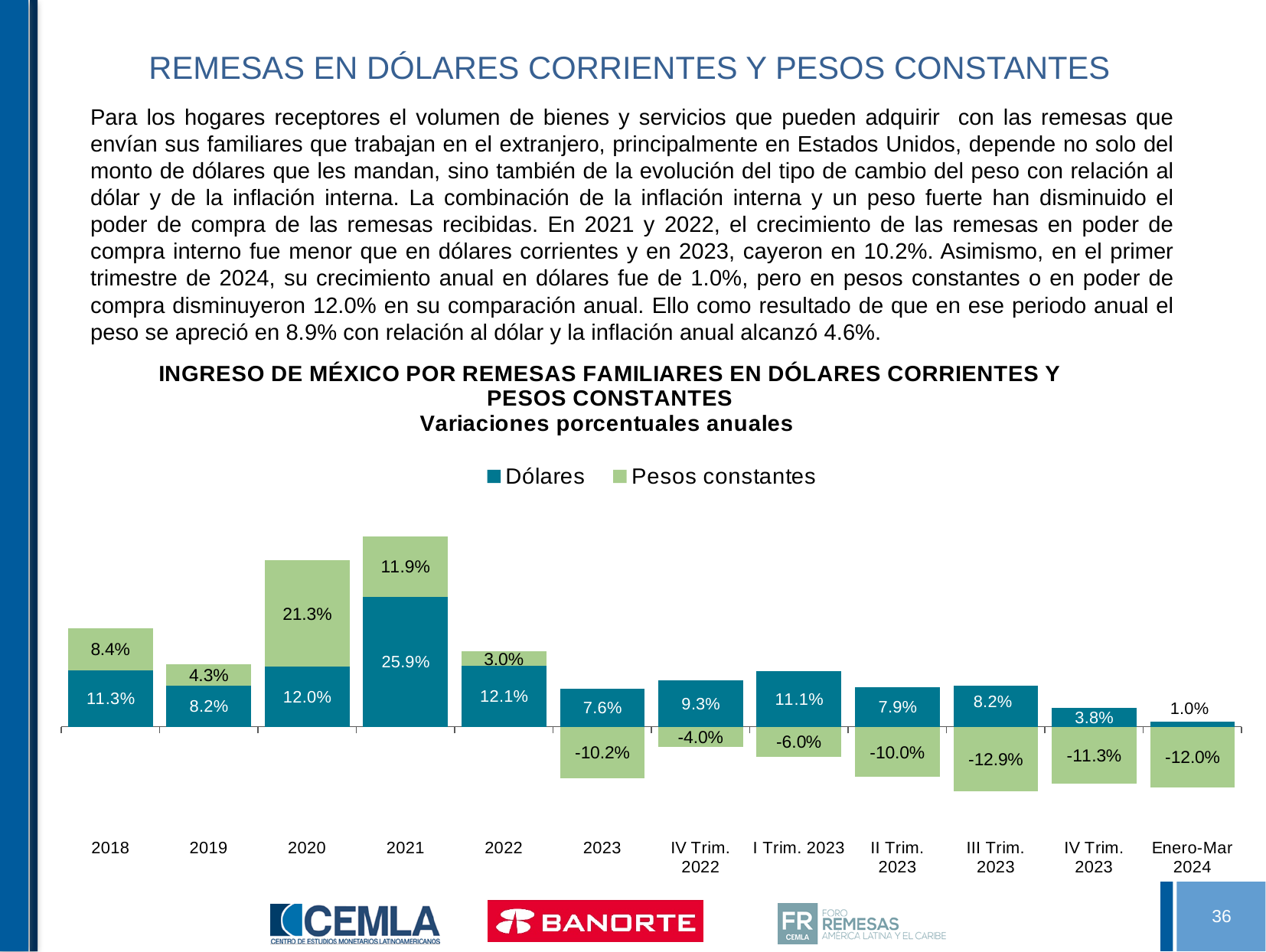
Which category has the lowest Pesos constantes value? III Trim. 2023 What are the two series named in the legend? Dólares and Pesos constantes What is the Pesos constantes value for 2020? 21.3% What is the difference between the Dólares value for 2021 and the Dólares value for 2022? 13.8% How many series does the legend list? 2 Which is larger, the Pesos constantes value for 2018 or for 2019? 2018 Which category has the highest Dólares value? 2021 How many categories are shown on the x axis? 12 What is the Pesos constantes value for Enero-Mar 2024? -12.0% What is the Dólares value for 2021? 25.9% What is the Dólares value for IV Trim. 2023? 3.8% What kind of chart is shown on the slide? Stacked bar chart